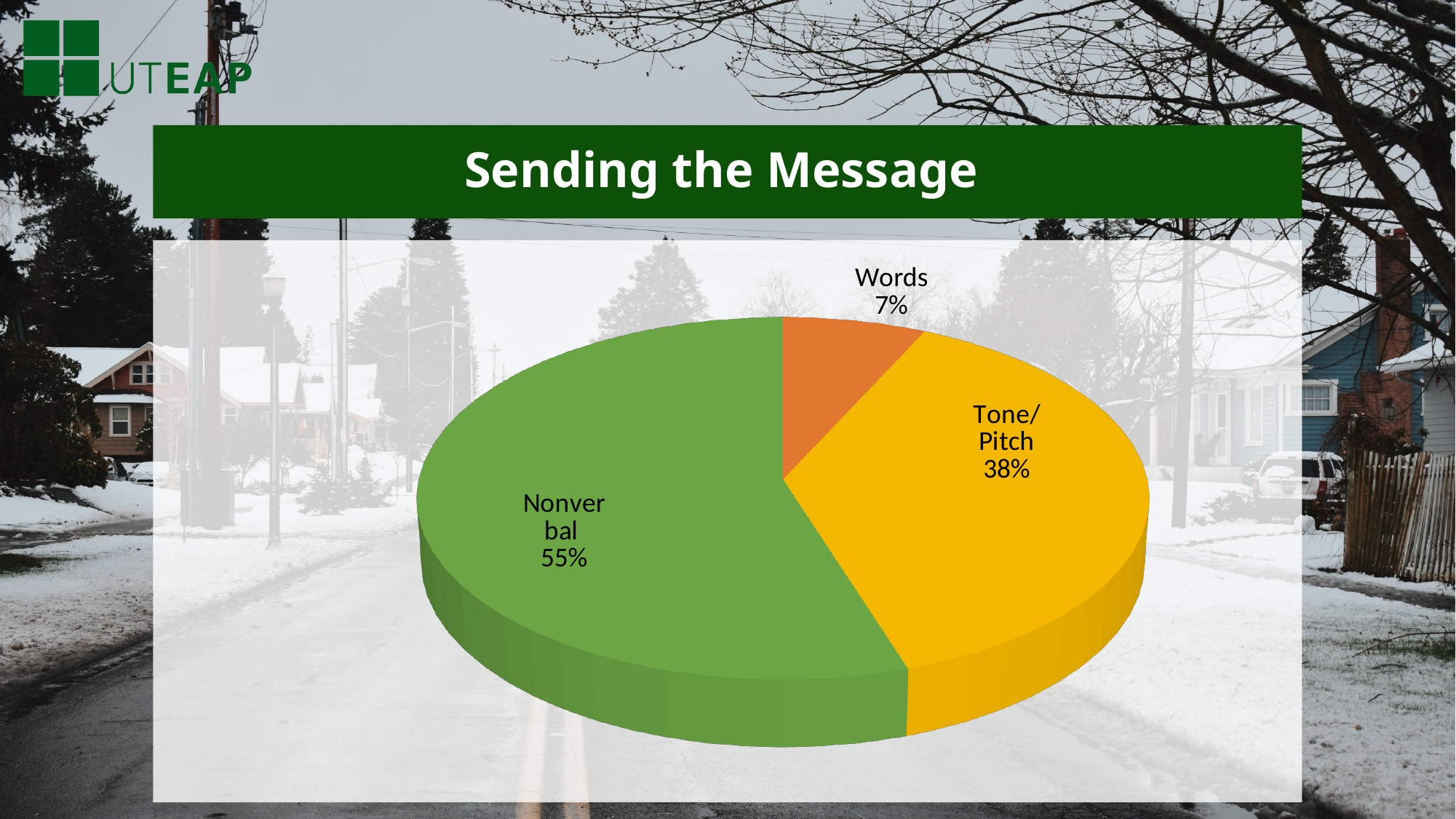
What is the difference in percentage points between Nonverbal and Tone/Pitch? 17 Which slice is the smallest? Words Which slice is the largest? Nonverbal What percentage does the Nonverbal slice represent? 55% What percentage does the Tone/Pitch slice represent? 38% How many slices does the pie chart have? 3 What percentage does the Words slice represent? 7% Which is larger, Tone/Pitch or Words? Tone/Pitch What kind of chart is shown on the slide? Pie chart What is the difference in percentage points between Tone/Pitch and Words? 31 What colour is the Words slice? Orange What is the title of the slide containing the chart? Sending the Message